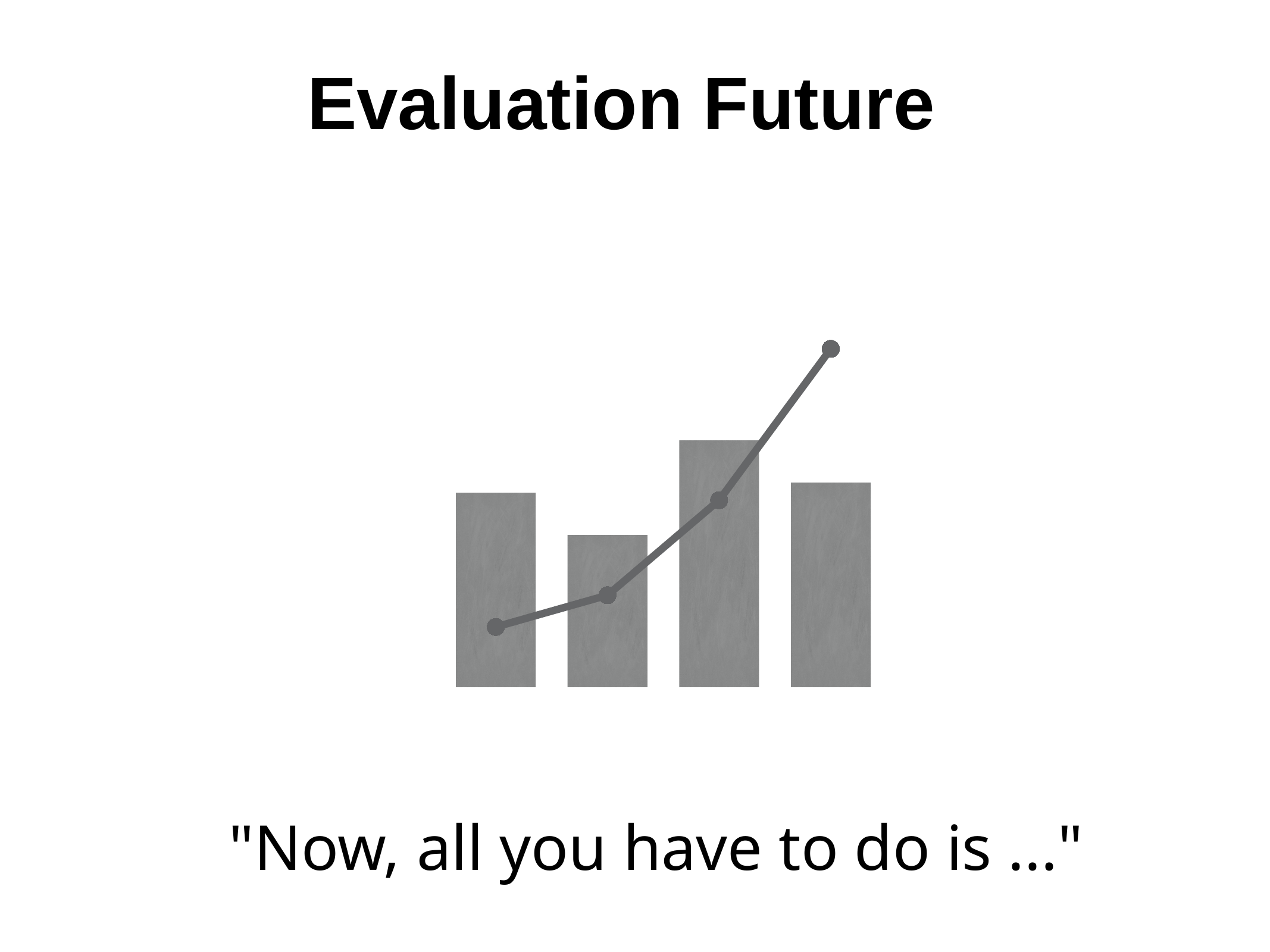
What colour are the bars in the chart? Gray How many bars does the chart on the slide have? 4 Is the fourth bar from the left taller or shorter than the third bar? Shorter Which bar in the chart is the shortest, counting from the left? The second bar Is the first bar from the left taller or shorter than the second bar? Taller How many points are marked on the line in the chart? 4 What kind of chart is shown on the slide? A bar chart with a line overlaid Which bar in the chart is the tallest, counting from the left? The third bar What is the title of the slide containing the chart? Evaluation Future Does the line in the chart rise or fall from left to right? Rises